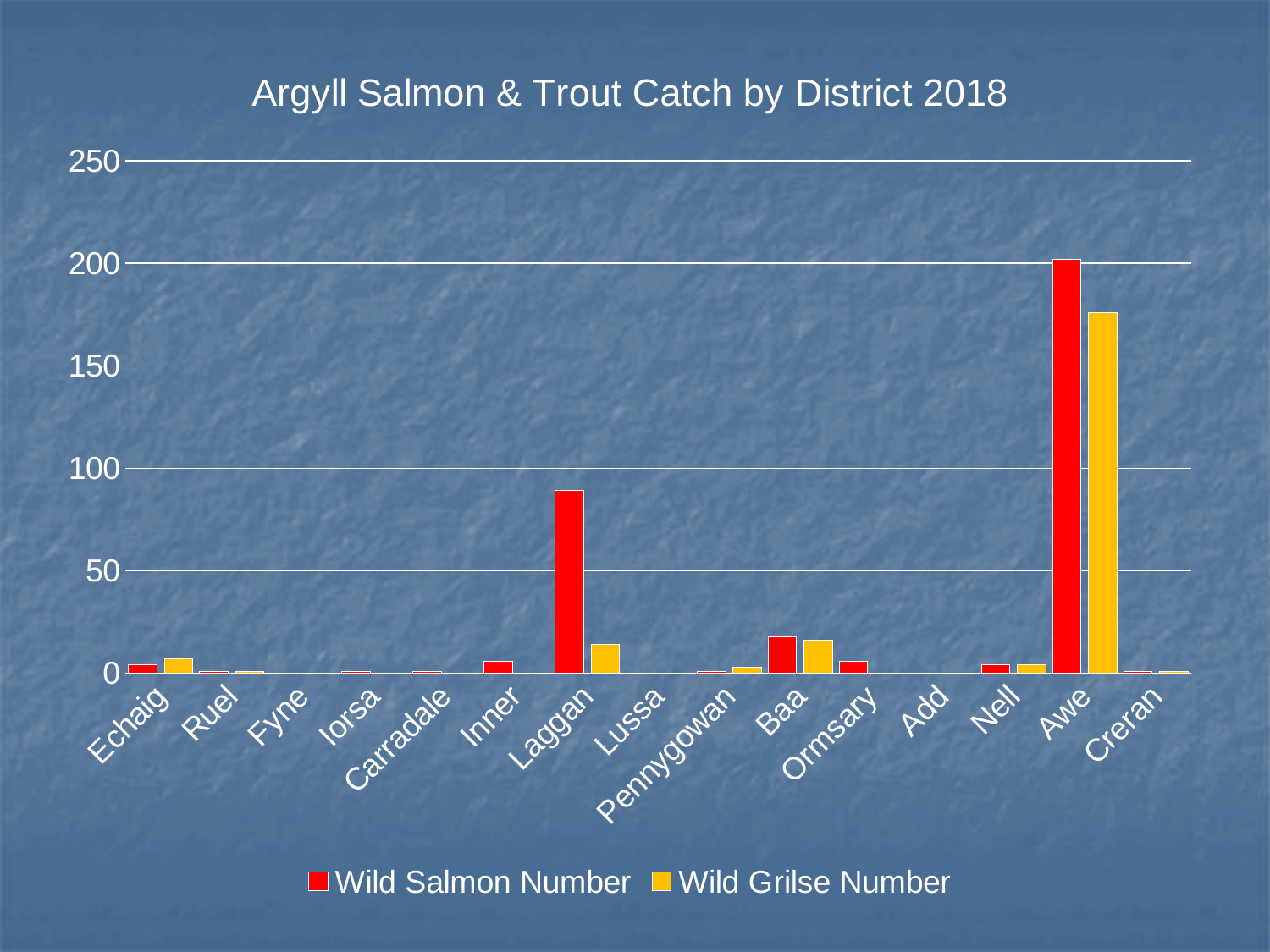
Is the Wild Salmon Number for Laggan greater or less than 100? less Which is larger, the Wild Salmon Number for Laggan or for Baa? Laggan How many series does the legend list? 2 What kind of chart is shown on the slide? bar chart For Awe, which is larger, the Wild Salmon Number or the Wild Grilse Number? Wild Salmon Number Is the Wild Salmon Number for Awe greater or less than 150? greater Is the Wild Grilse Number for Awe greater or less than 200? less How many districts are shown on the x axis? 15 Which district has the highest Wild Grilse Number? Awe Which district has the highest Wild Salmon Number? Awe What is the title of the chart? Argyll Salmon & Trout Catch by District 2018